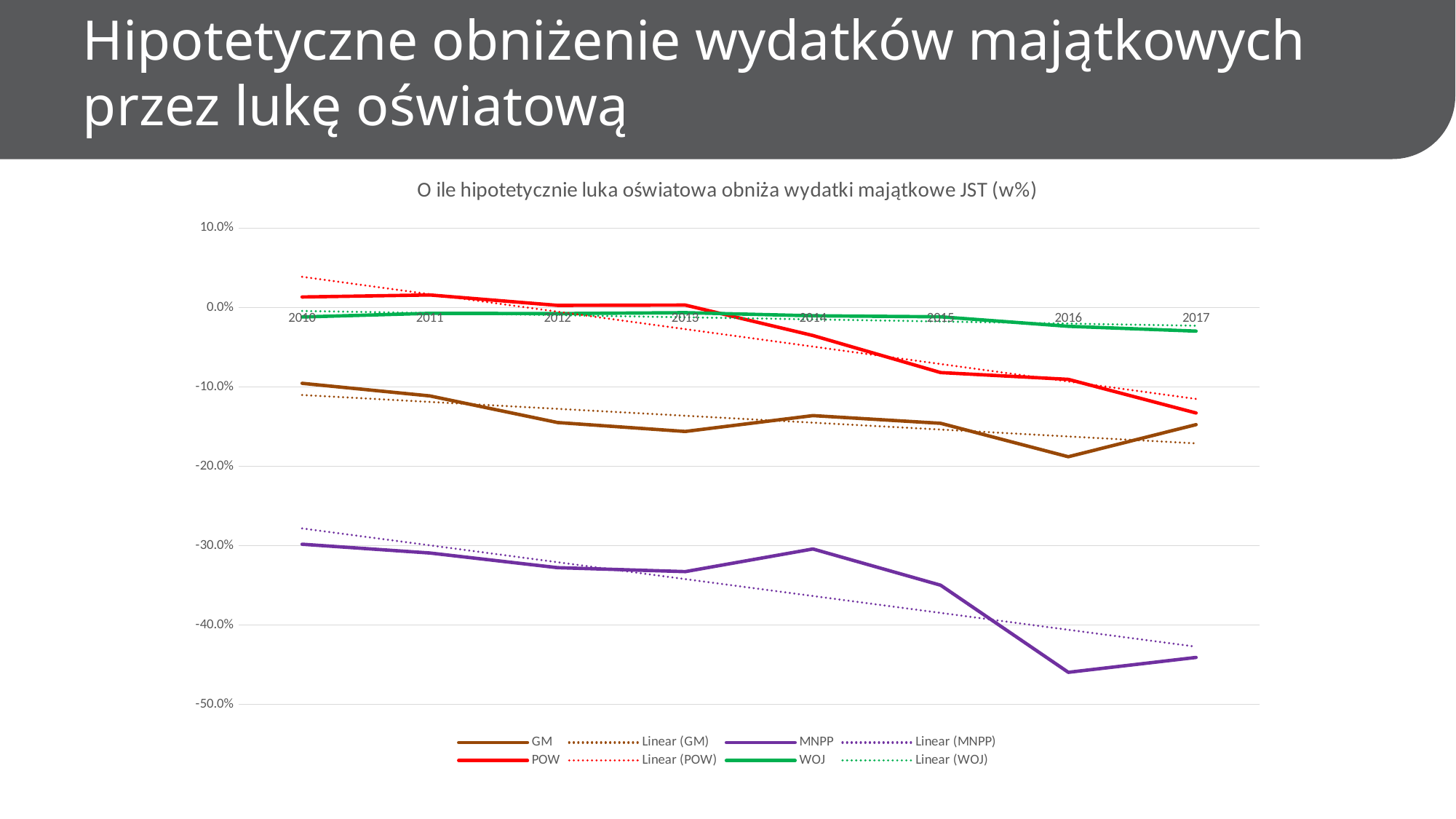
Does the POW series generally rise or fall from 2010 to 2017? fall Is the value for GM in 2016 greater or less than -10.0%? less Is the value for POW in 2017 greater or less than -10.0%? less How many series does the chart's legend list? 8 Which series has the lowest value in 2016? MNPP Is the value for MNPP in 2016 greater or less than -40.0%? less Which series has the highest value in 2017? WOJ What is the title of the chart? O ile hipotetycznie luka oświatowa obniża wydatki majątkowe JST (w%) Which is larger, the MNPP value in 2014 or the MNPP value in 2015? 2014 What kind of chart is shown on the slide? line chart How many years are plotted along the x axis of the chart? 8